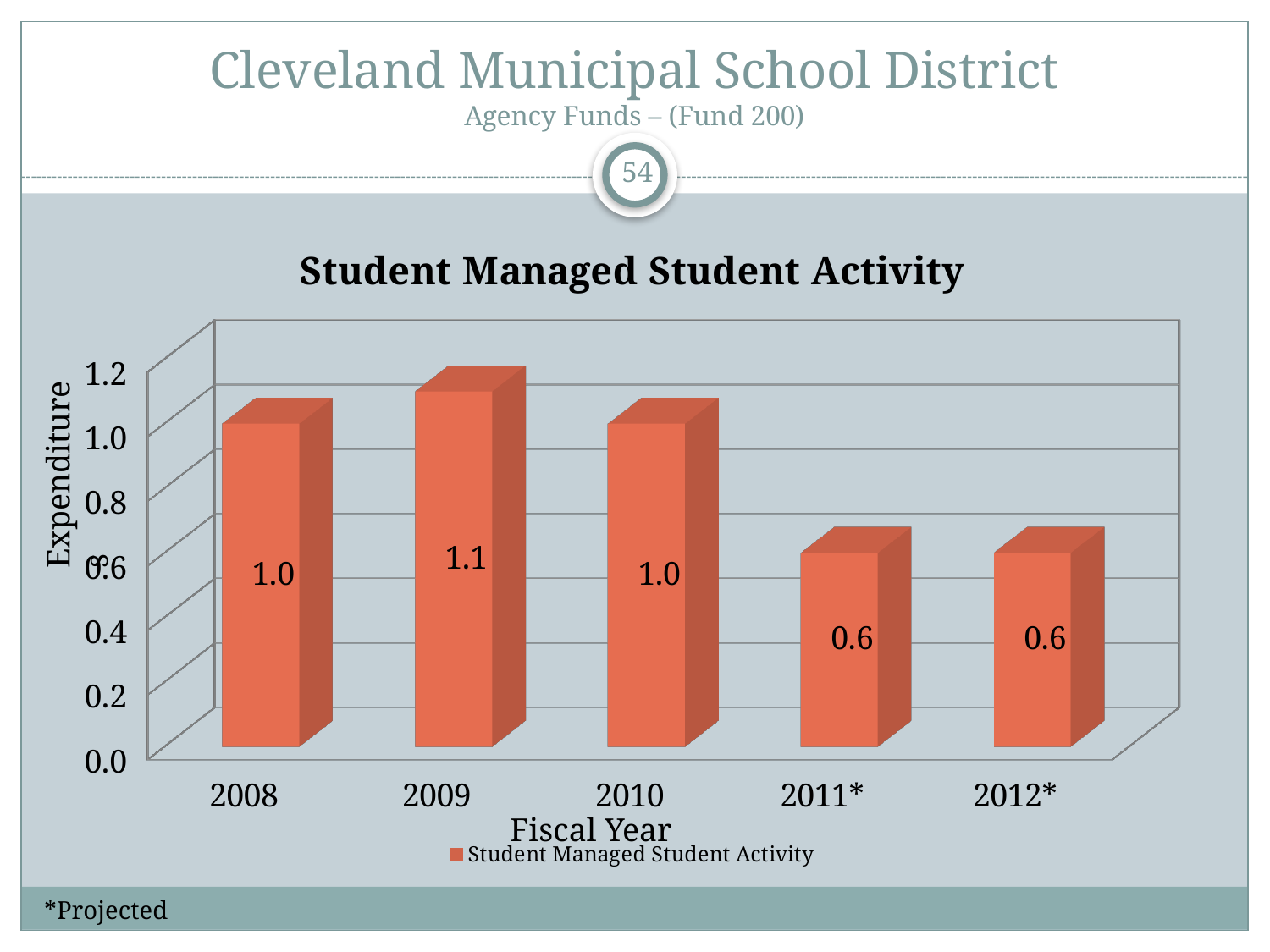
What is the value for 2011*? 0.6 What is the difference between the values for 2009 and 2012*? 0.5 How many fiscal years are shown on the x axis? 5 Which fiscal year has the highest value? 2009 What kind of chart is shown? bar chart What is the value for 2008? 1.0 What is the value for 2009? 1.1 Do the values rise or fall from 2010 to 2011*? fall What is the title of the chart? Student Managed Student Activity How many series does the legend list? 1 Which is larger, the value for 2010 or the value for 2011*? 2010 Is the value for 2009 greater or less than 1.0? greater